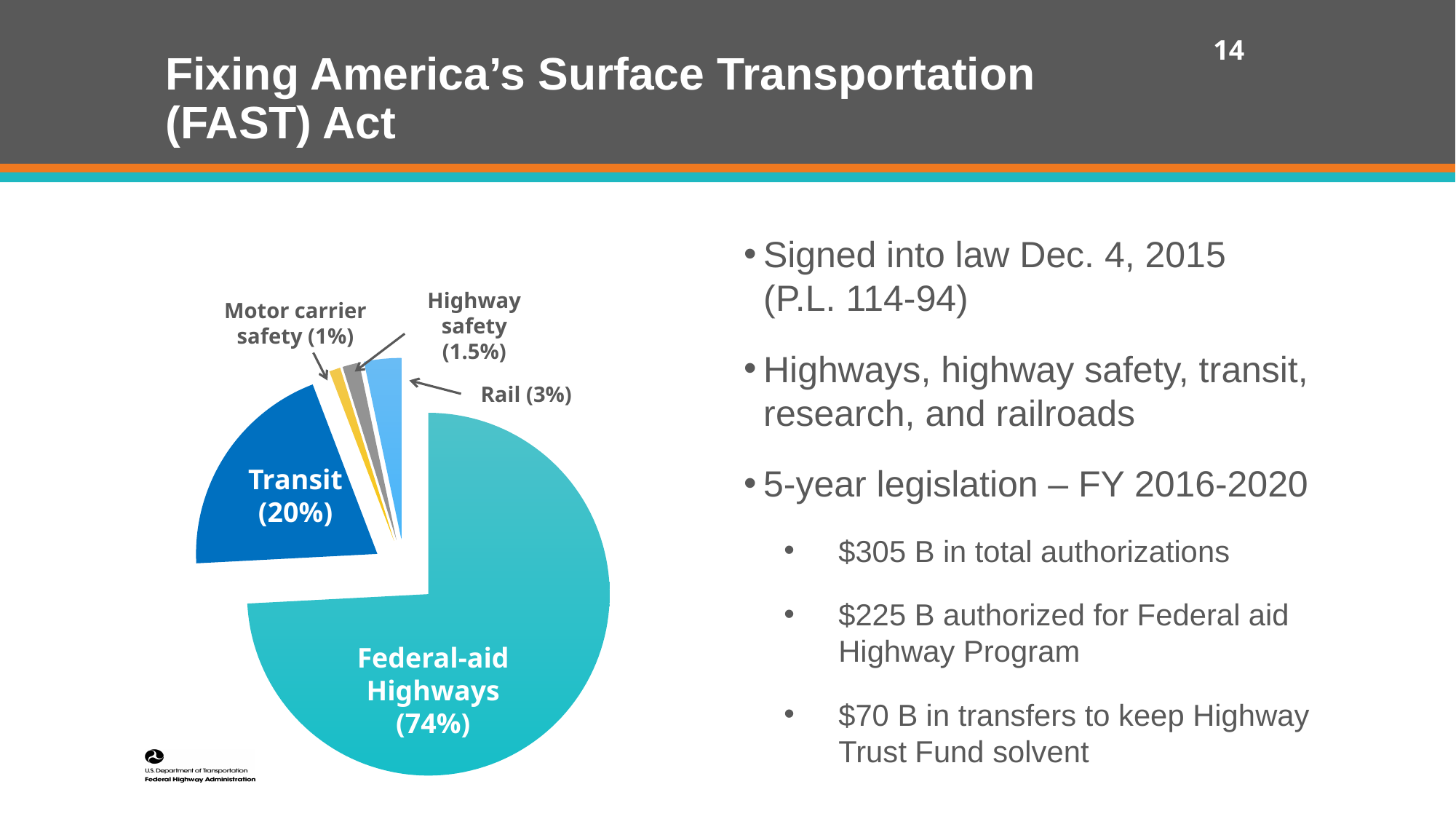
What is the difference in percentage points between the Federal-aid Highways and Transit slices? 54 What share of the pie does Transit represent? 20% What share of the pie does Highway safety represent? 1.5% What kind of chart is shown on the slide? Pie chart Which slice of the pie chart is the largest? Federal-aid Highways What colour is the Transit slice of the pie chart? Dark blue What share of the pie does Federal-aid Highways represent? 74% Which is larger, the Rail slice or the Highway safety slice? Rail How many slices does the pie chart have? 5 Which slice of the pie chart is the smallest? Motor carrier safety